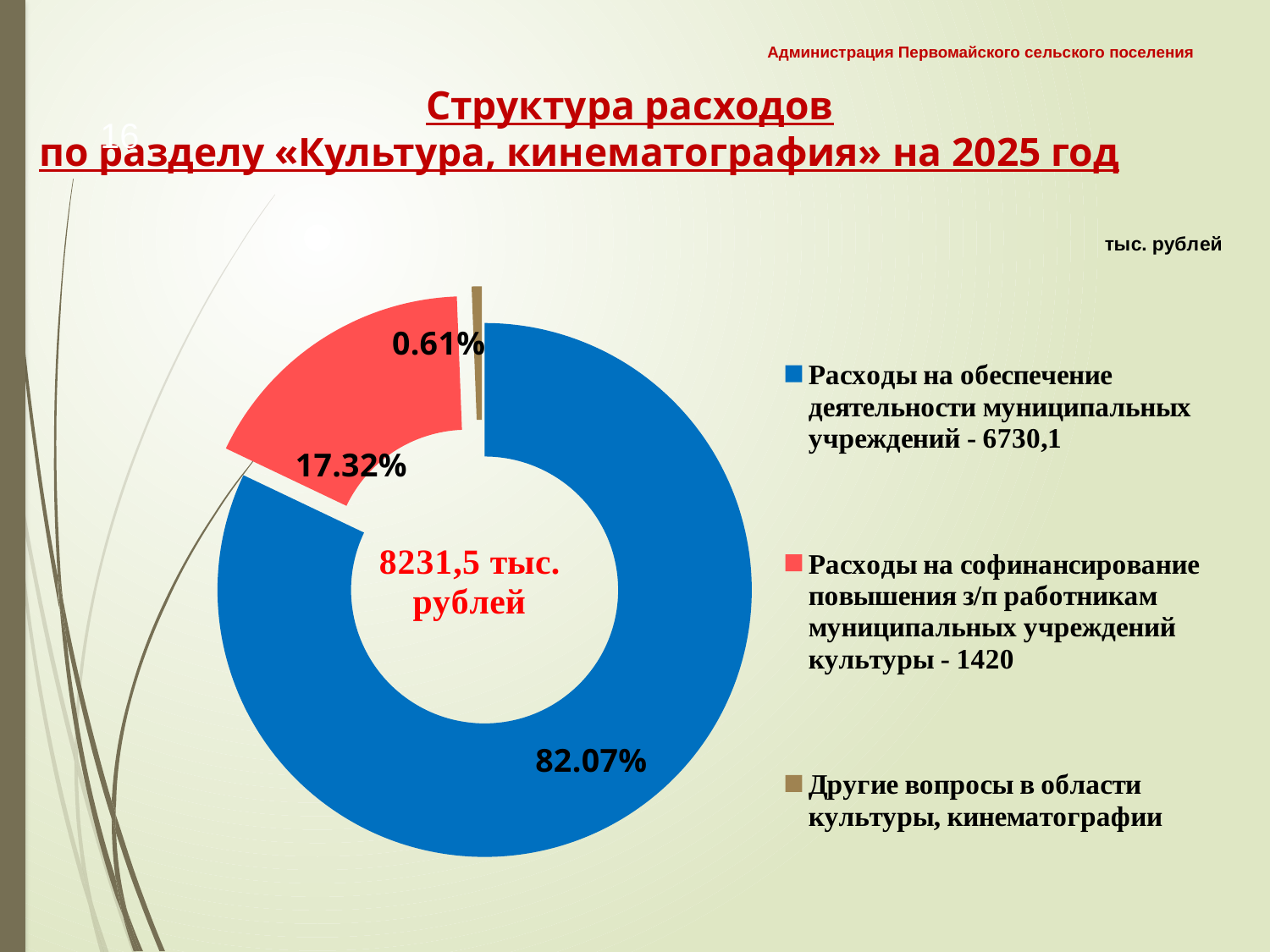
What amount (тыс. рублей) is given in the legend for «Расходы на софинансирование повышения з/п работникам муниципальных учреждений культуры»? 1420 What amount (тыс. рублей) is given in the legend for «Расходы на обеспечение деятельности муниципальных учреждений»? 6730,1 What total amount is shown in the centre of the doughnut chart? 8231,5 тыс. рублей How many categories does the chart show? 3 What type of chart is shown on the slide? Doughnut (pie) chart What share of expenditures is labelled for «Другие вопросы в области культуры, кинематографии»? 0.61% What share of expenditures is labelled for «Расходы на софинансирование повышения з/п работникам муниципальных учреждений культуры»? 17.32% What is the difference in percentage points between the 82.07% slice and the 17.32% slice? 64.75% Which category has the largest share of the chart? Расходы на обеспечение деятельности муниципальных учреждений What share of expenditures is labelled for «Расходы на обеспечение деятельности муниципальных учреждений»? 82.07% Which colour represents «Расходы на софинансирование повышения з/п работникам муниципальных учреждений культуры» in the chart? Red Which category has the smallest share of the chart? Другие вопросы в области культуры, кинематографии